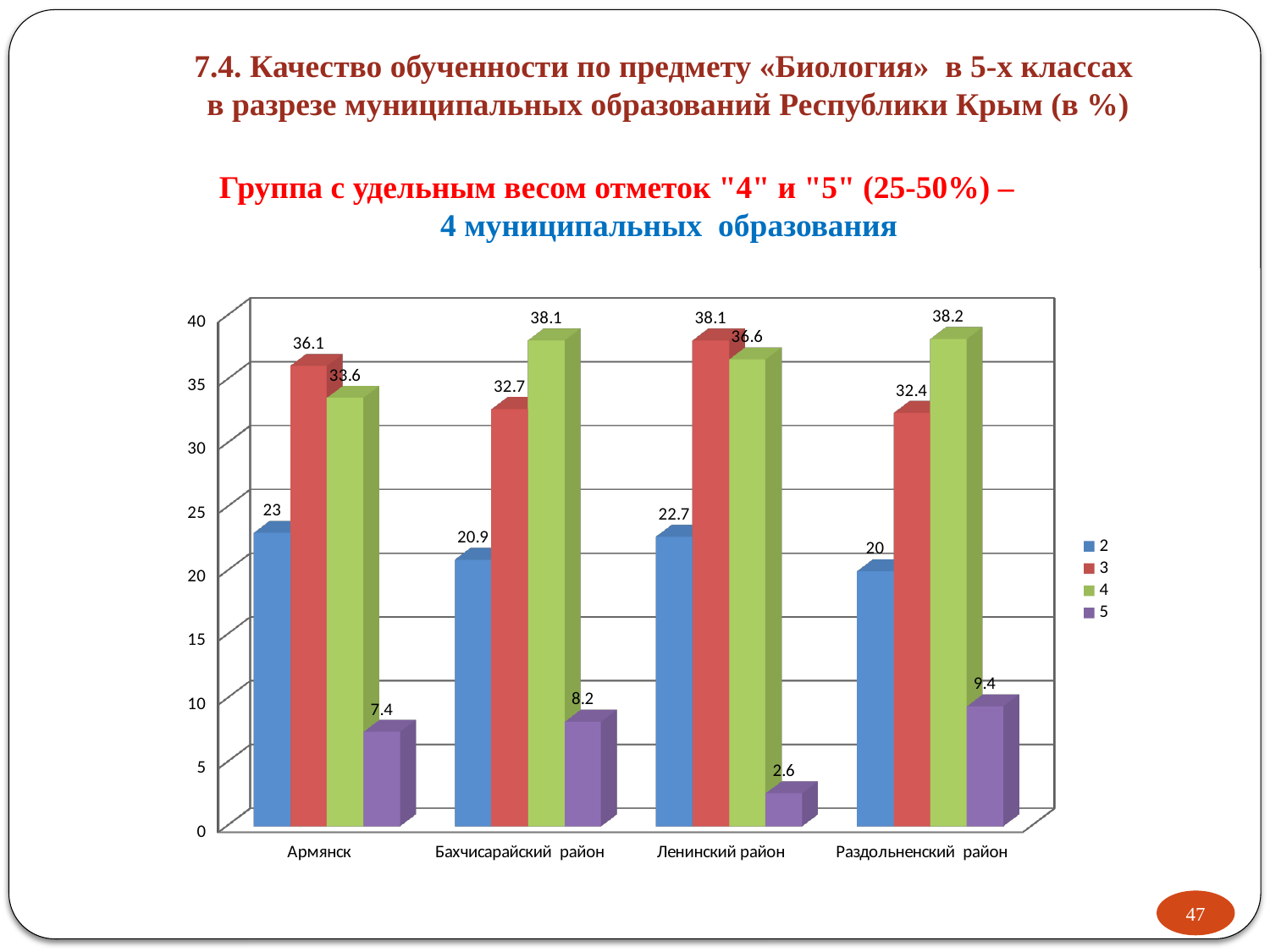
What kind of chart is shown on the slide? bar chart What is the value for series "3" in Бахчисарайский район? 32.7 Which category has the lowest value for series "2"? Раздольненский район Which is larger in Ленинский район: the value for series "3" or series "4"? series "3" Which category has the highest value for series "5"? Раздольненский район What is the difference between the values for series "3" and series "4" in Армянск? 2.5 What colour are the bars for series "4" in the legend? green What is the value for series "5" in Ленинский район? 2.6 How many series does the legend list? 4 What is the value for series "2" in Армянск? 23 How many categories are shown on the x axis? 4 What is the value for series "4" in Раздольненский район? 38.2